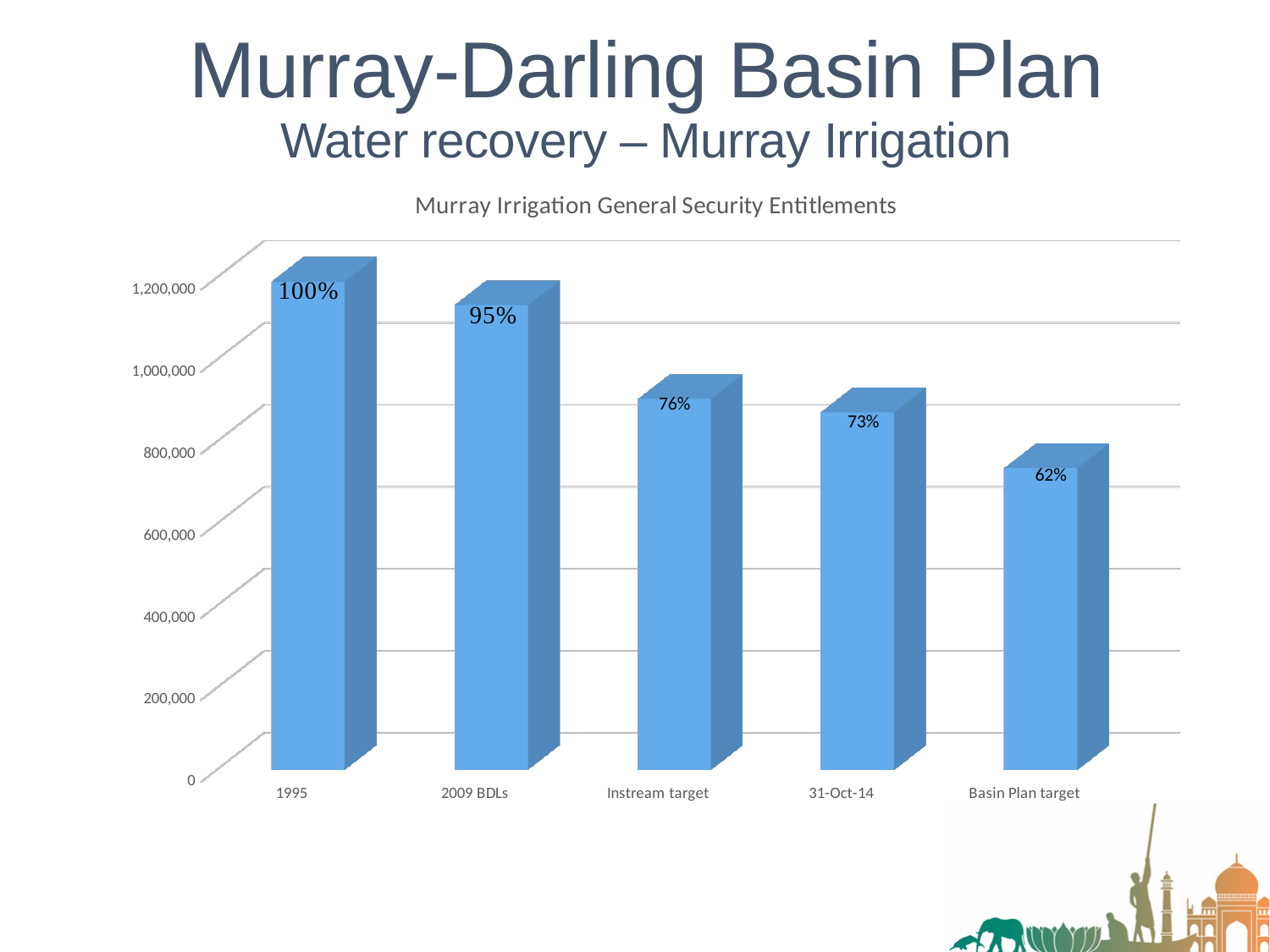
What percentage label is shown on the Basin Plan target bar? 62% What percentage label is shown on the Instream target bar? 76% Which category has the highest bar? 1995 Do the values rise or fall from left to right along the x axis? fall Which category has the lowest bar? Basin Plan target What percentage label is shown on the 2009 BDLs bar? 95% How many categories are shown on the x axis? 5 Is the value for 2009 BDLs greater or less than 1,000,000? greater Which is larger, the value for Instream target or the value for 31-Oct-14? Instream target What percentage label is shown on the 31-Oct-14 bar? 73% What is the difference in percentage points between the 2009 BDLs label and the Basin Plan target label? 33 What percentage label is shown on the 1995 bar? 100%